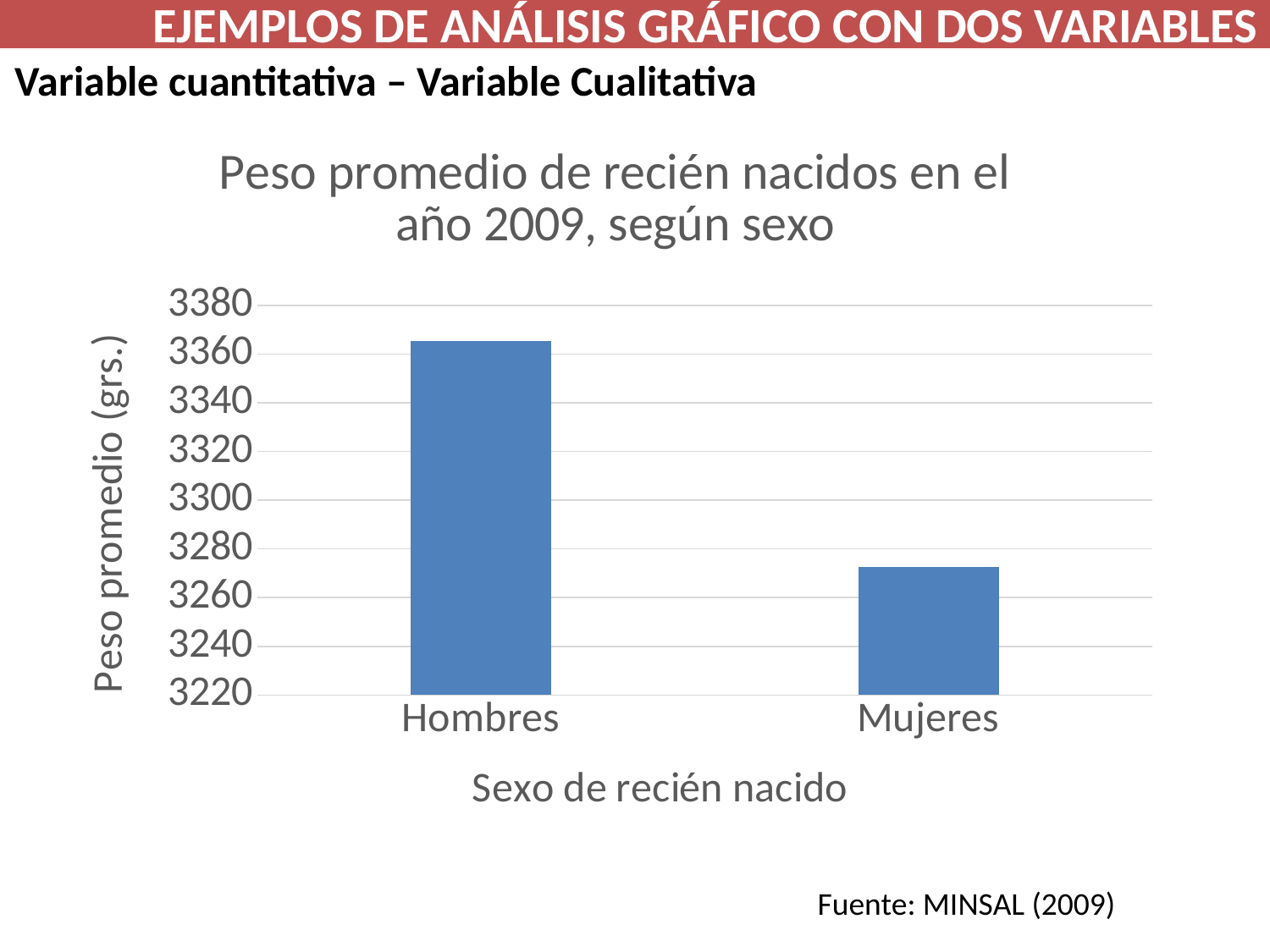
What is the label of the y axis? Peso promedio (grs.) How many categories are plotted on the x axis? 2 What is the title of the chart? Peso promedio de recién nacidos en el año 2009, según sexo Which is larger, the value for Hombres or the value for Mujeres? Hombres Is the value for Hombres greater or less than 3340? greater Which category has the lowest average weight? Mujeres What kind of chart is shown on the slide? bar chart Which category has the highest average weight? Hombres Is the value for Mujeres greater or less than 3300? less Is the value for Hombres greater or less than 3380? less